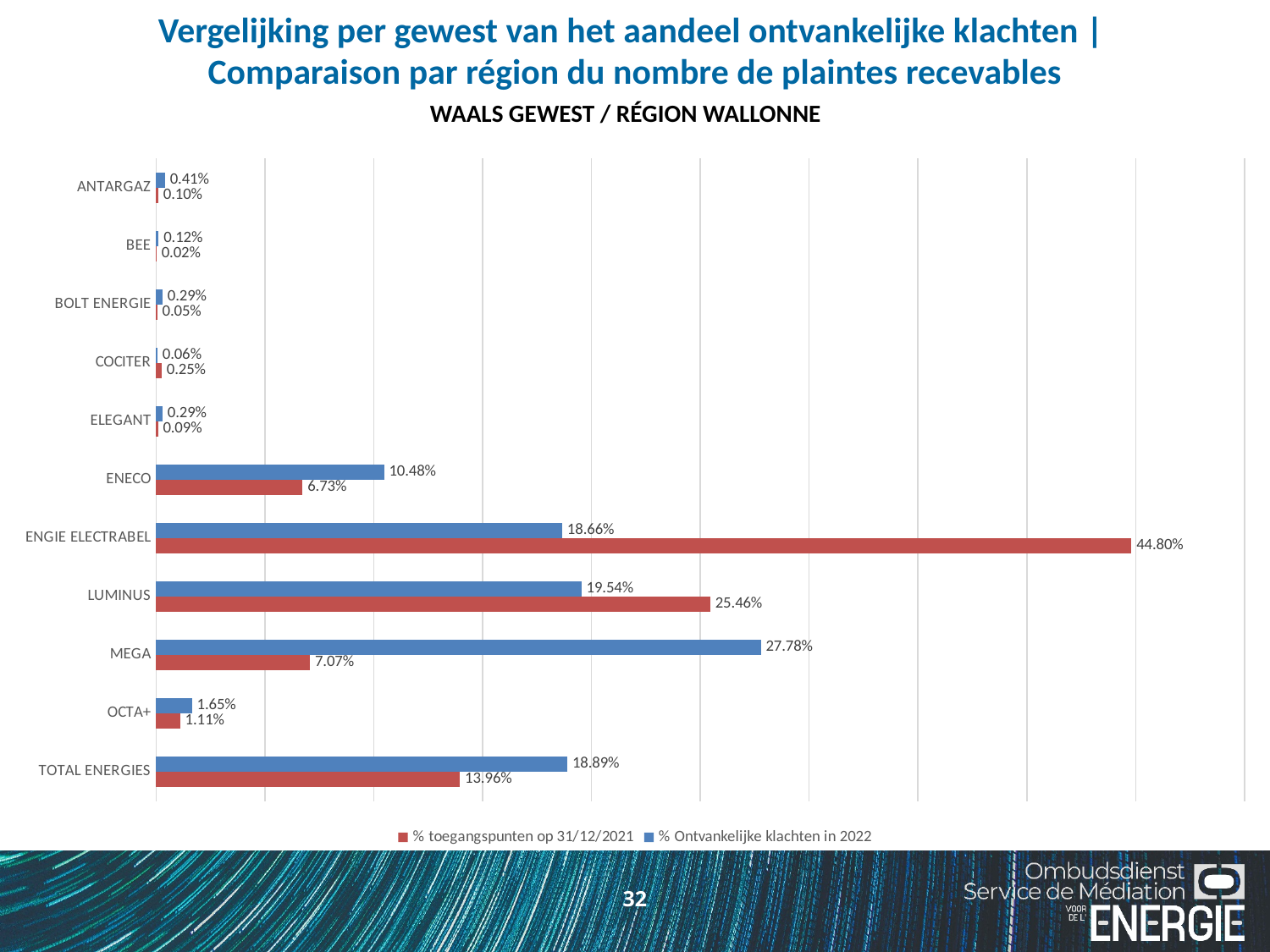
What is the difference between the '% Ontvankelijke klachten in 2022' values for TOTAL ENERGIES and ENECO? 8.41% What is the value of '% toegangspunten op 31/12/2021' for ENGIE ELECTRABEL? 44.80% What is the value of '% toegangspunten op 31/12/2021' for OCTA+? 1.11% Which colour represents '% Ontvankelijke klachten in 2022' in the chart? blue How many series does the legend list? 2 What type of chart is shown on the slide? bar chart How many suppliers (categories) are shown on the chart? 11 What is the value of '% Ontvankelijke klachten in 2022' for MEGA? 27.78% For LUMINUS, which is larger: '% toegangspunten op 31/12/2021' or '% Ontvankelijke klachten in 2022'? % toegangspunten op 31/12/2021 What is the difference between the '% toegangspunten op 31/12/2021' and '% Ontvankelijke klachten in 2022' values for ENGIE ELECTRABEL? 26.14% Which supplier has the lowest value for '% toegangspunten op 31/12/2021'? BEE Which supplier has the highest value for '% Ontvankelijke klachten in 2022'? MEGA